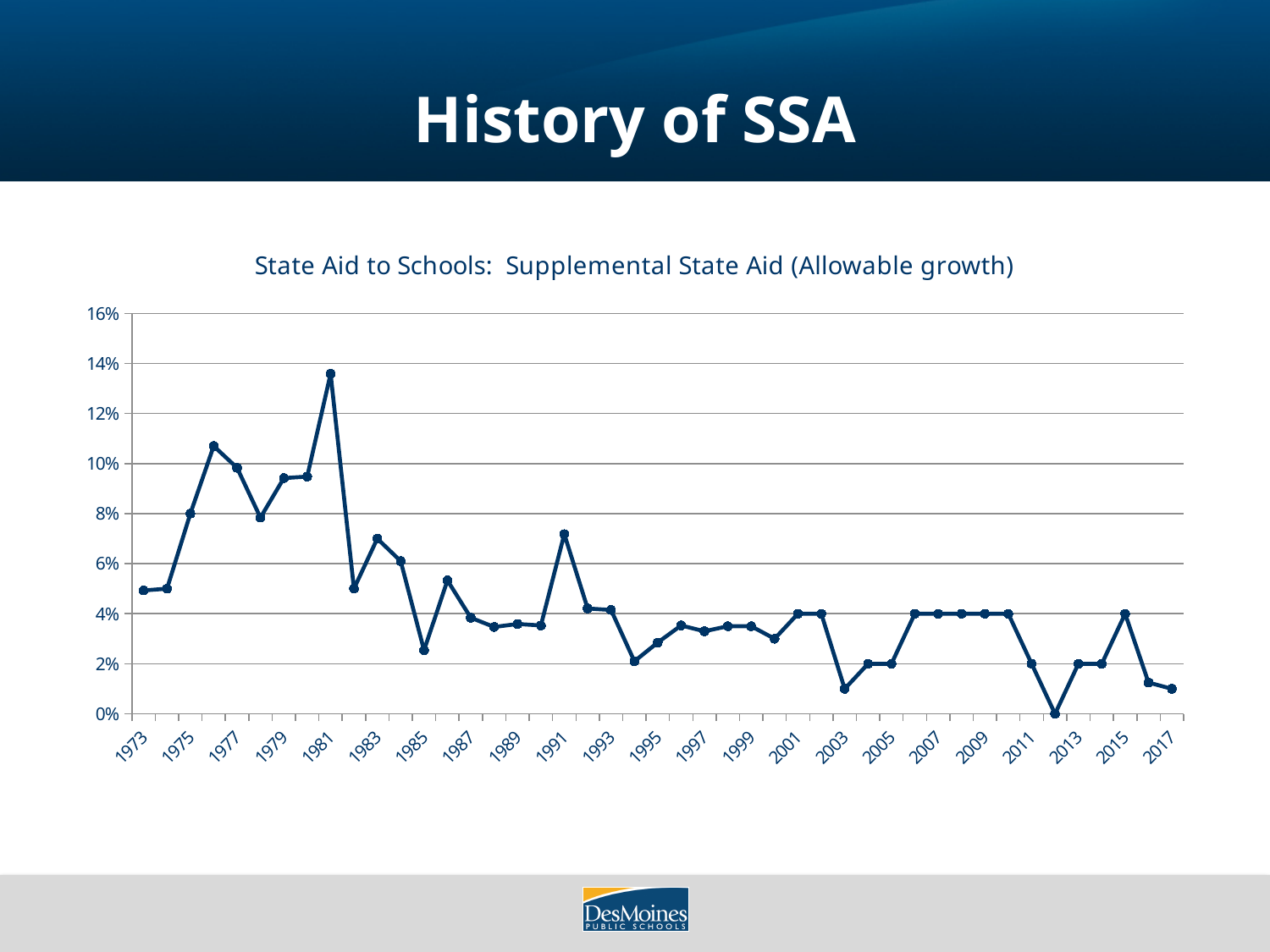
Which year has the larger value, 1977 or 1991? 1977 Is the value for 1985 greater or less than 4%? less What is the Supplemental State Aid value for 2007? 4% What is the Supplemental State Aid value for 1975? 8% What is the Supplemental State Aid value for 2011? 2% What is the Supplemental State Aid value for 2015? 4% What is the difference between the values for 2007 and 2011? 2% Is the value for 1981 greater or less than 12%? greater What kind of chart is shown on the slide? line chart Overall, do the values rise or fall from 1973 to 2017? fall Which year has the highest Supplemental State Aid value? 1981 Is the value for 2017 greater or less than 2%? less